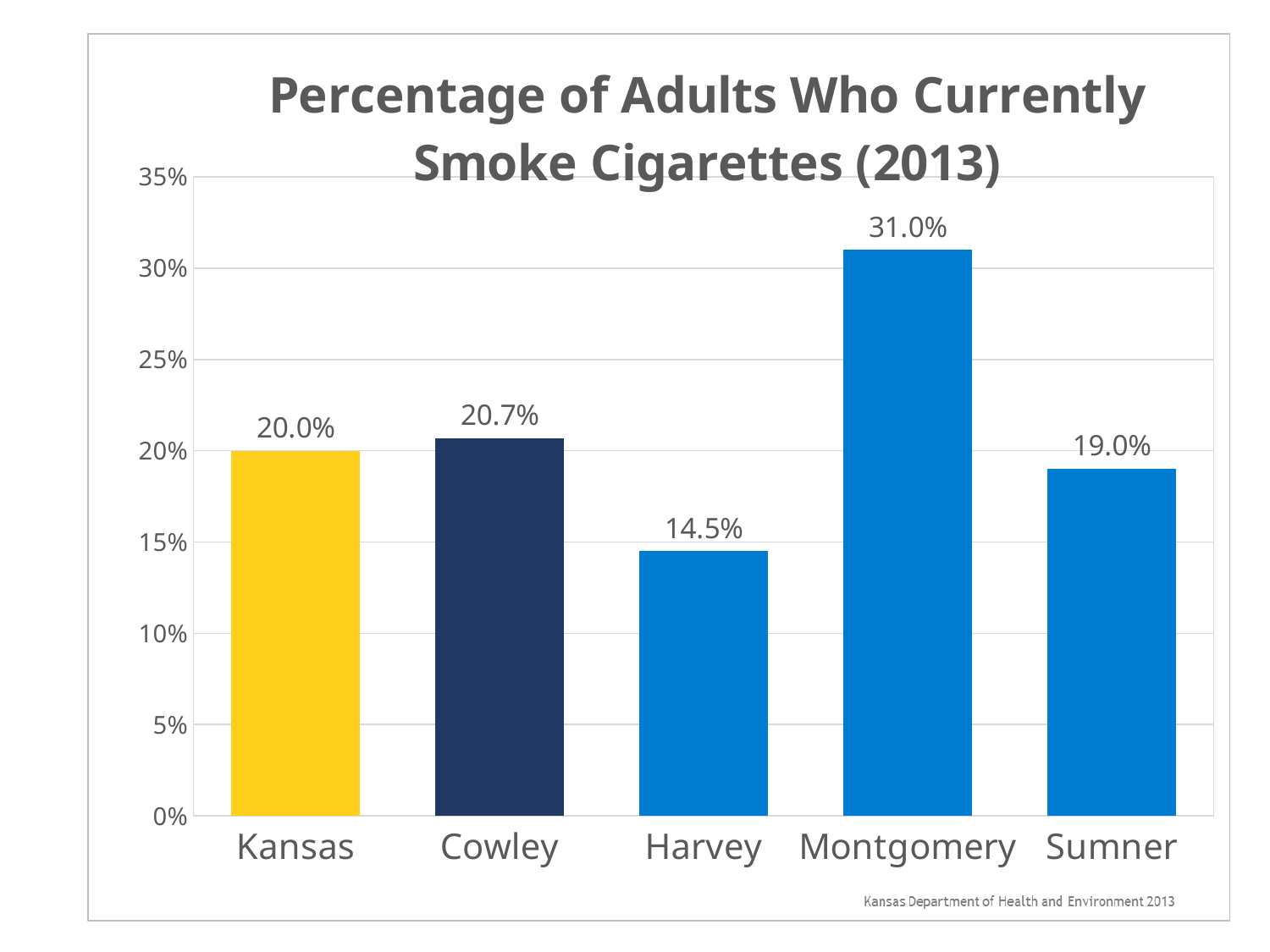
What kind of chart is shown on the slide? bar chart What is the title of the chart? Percentage of Adults Who Currently Smoke Cigarettes (2013) Is the value for Harvey greater or less than 15%? less Which category has the highest percentage of adults who currently smoke? Montgomery How many categories are shown on the x axis? 5 Which has a higher value, Sumner or Montgomery? Montgomery What is the value shown for Harvey? 14.5% What is the difference between the values for Cowley and Kansas? 0.7% What is the value shown for Kansas? 20.0% What is the percentage of adults who currently smoke cigarettes in Montgomery? 31.0% Which category has the lowest percentage of adults who currently smoke? Harvey What is the difference between the values for Montgomery and Harvey? 16.5%